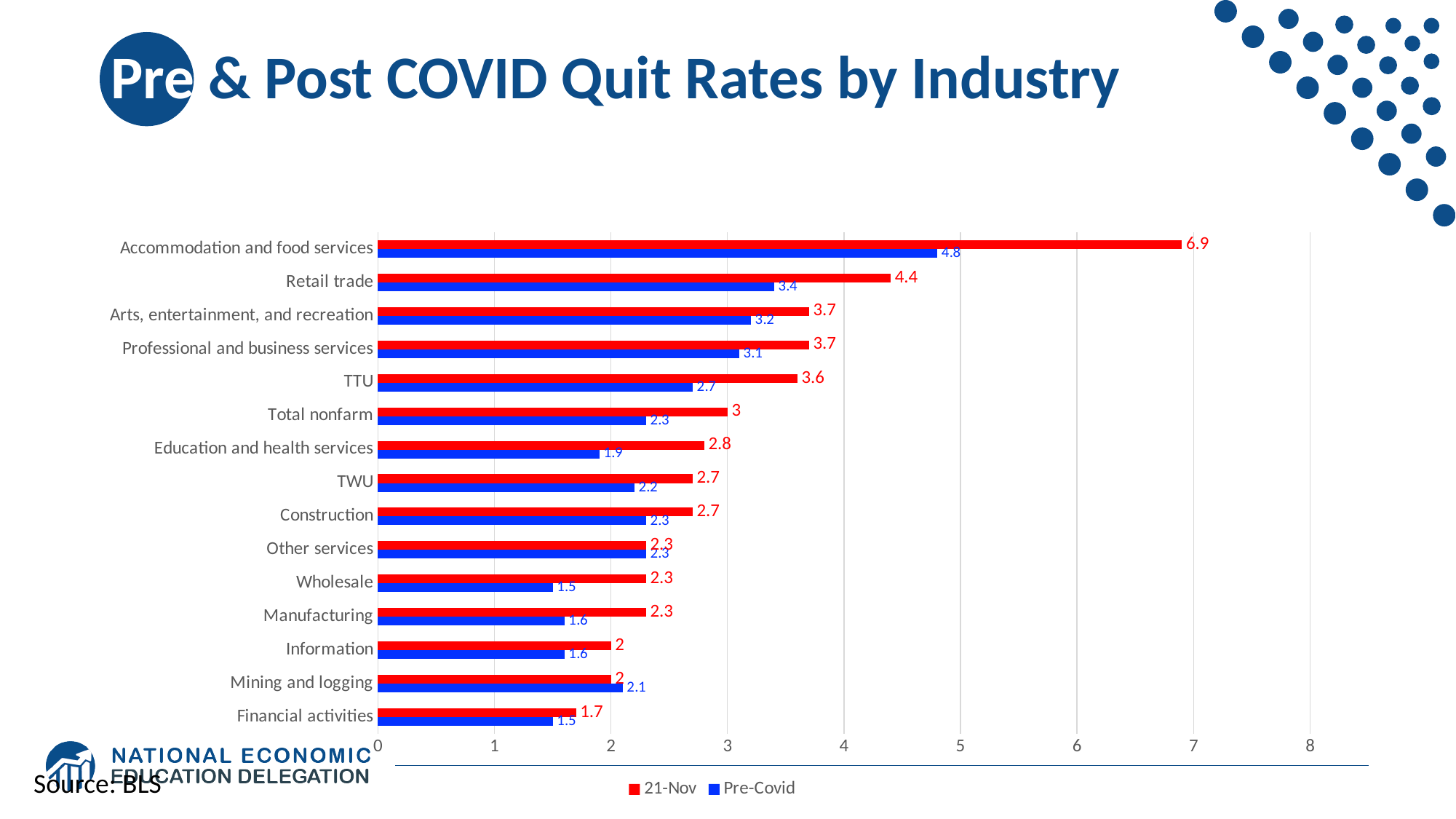
Which industry has the highest 21-Nov quit rate? Accommodation and food services Which is larger for Mining and logging, the 21-Nov quit rate or the Pre-Covid quit rate? Pre-Covid Which colour represents the Pre-Covid series? Blue What kind of chart is shown on the slide? Bar chart How many industries are shown on the chart? 15 What is the 21-Nov quit rate for Total nonfarm? 3 What is the Pre-Covid quit rate for Retail trade? 3.4 Which industry has the lowest 21-Nov quit rate? Financial activities How many series does the legend list? 2 What is the 21-Nov quit rate for Accommodation and food services? 6.9 Is the 21-Nov quit rate for Retail trade greater or less than 4? greater What is the difference between the 21-Nov and Pre-Covid quit rates for Accommodation and food services? 2.1